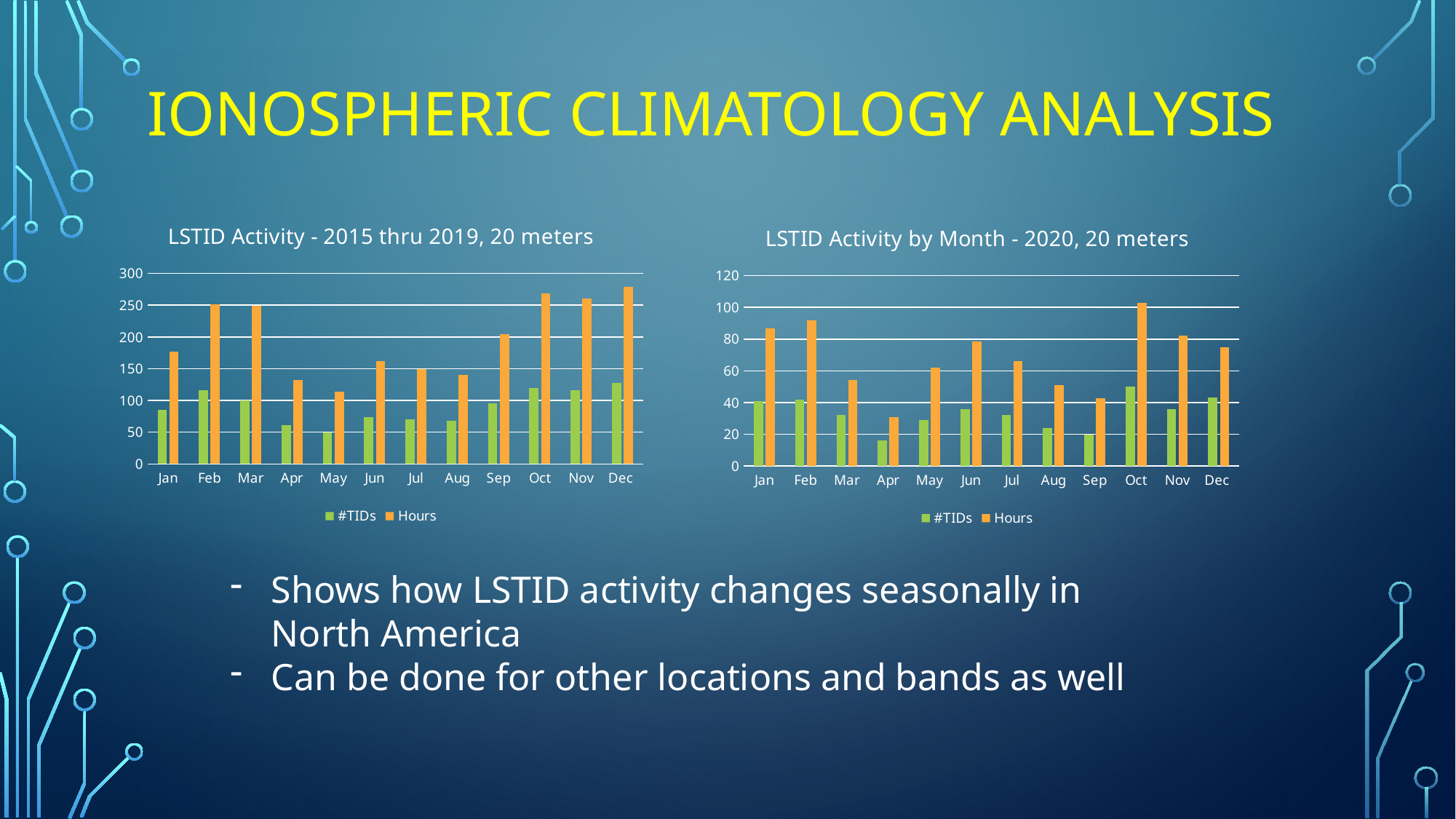
In the chart titled "LSTID Activity - 2015 thru 2019, 20 meters", which is larger, the Hours value for Sep or the Hours value for Apr? Sep In the chart titled "LSTID Activity by Month - 2020, 20 meters", is the Hours value for Apr greater or less than 40? less In the chart titled "LSTID Activity by Month - 2020, 20 meters", how many months are shown on the x axis? 12 In the chart titled "LSTID Activity by Month - 2020, 20 meters", is the Hours value for Feb greater or less than 80? greater In the chart titled "LSTID Activity by Month - 2020, 20 meters", which month has the highest Hours value? Oct What type of chart is the chart titled "LSTID Activity by Month - 2020, 20 meters"? Bar chart In the chart titled "LSTID Activity - 2015 thru 2019, 20 meters", which month has the highest Hours value? Dec How many series does the legend of the chart titled "LSTID Activity - 2015 thru 2019, 20 meters" list? 2 In the chart titled "LSTID Activity - 2015 thru 2019, 20 meters", is the #TIDs value for May greater or less than 100? less In the chart titled "LSTID Activity - 2015 thru 2019, 20 meters", which month has the lowest Hours value? May In the chart titled "LSTID Activity by Month - 2020, 20 meters", which month has the lowest #TIDs value? Apr